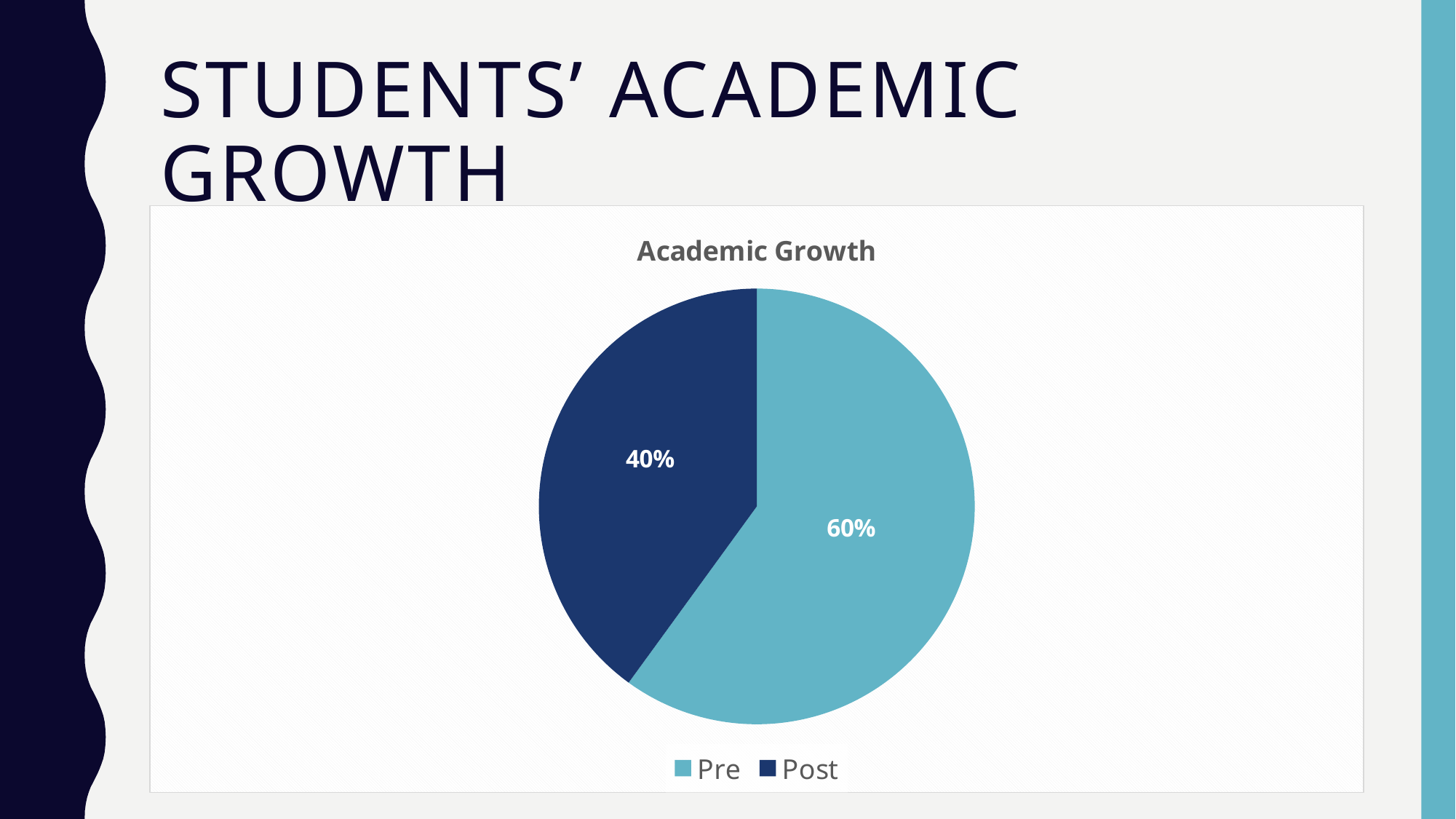
How many slices does the pie chart have? 2 What is the difference between the Pre and Post shares? 20% Which slice is the largest in the pie chart? Pre What colour is the Post slice in the pie chart? dark blue What kind of chart is shown on the slide? pie chart How many entries does the legend list? 2 Which slice is the smallest in the pie chart? Post Which is larger, the Pre slice or the Post slice? Pre What share of the pie does the Post slice represent? 40% What share of the pie does the Pre slice represent? 60% What is the title of the chart? Academic Growth